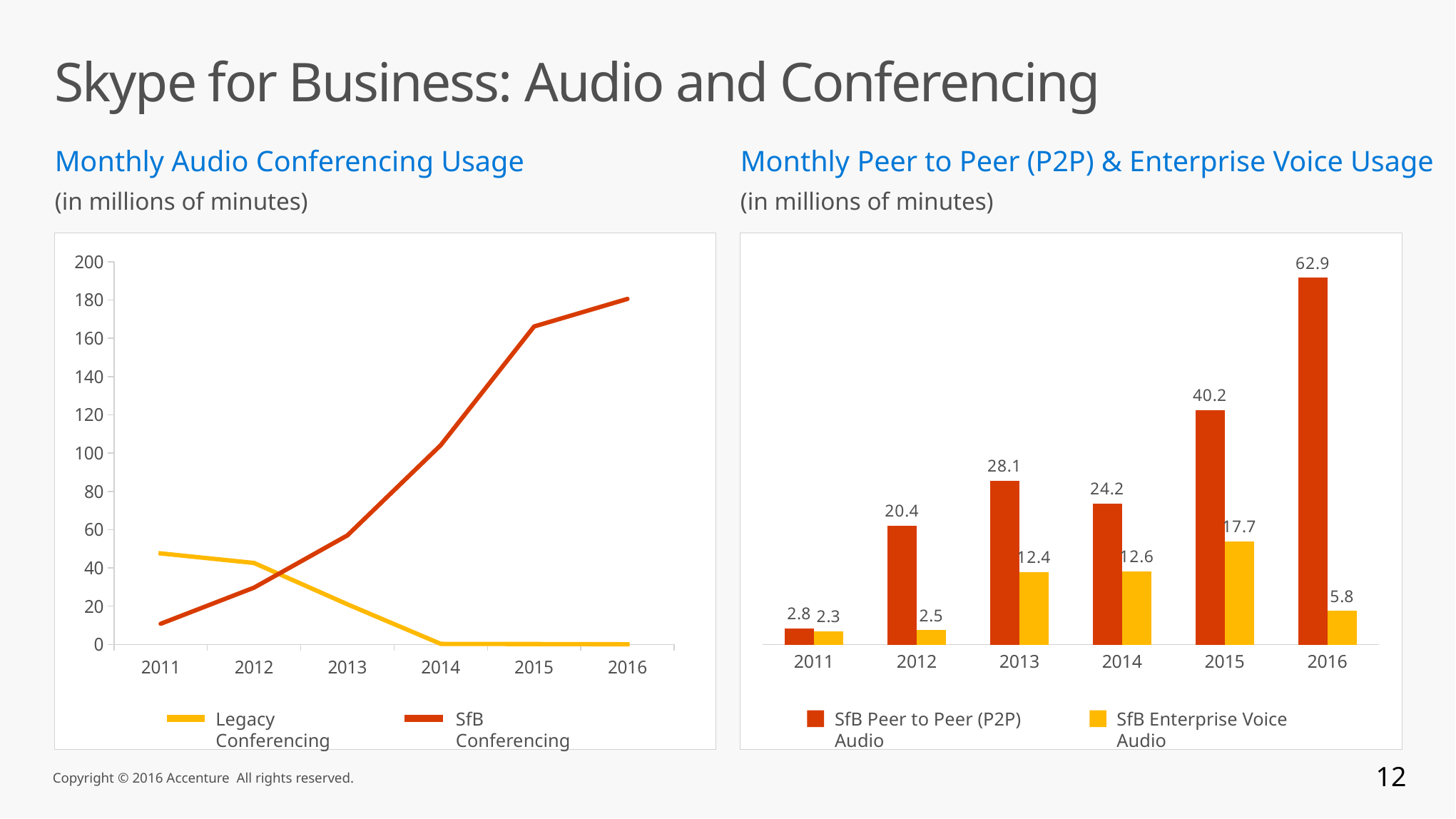
In the Monthly Peer to Peer (P2P) & Enterprise Voice Usage chart, what is the difference between SfB Peer to Peer (P2P) Audio and SfB Enterprise Voice Audio in 2016? 57.1 In the Monthly Audio Conferencing Usage chart, is the value for SfB Conferencing in 2016 greater or less than 160? greater In the Monthly Audio Conferencing Usage chart, is the value for Legacy Conferencing in 2011 greater or less than 60? less In the Monthly Peer to Peer (P2P) & Enterprise Voice Usage chart, how many years are shown on the x axis? 6 In the Monthly Peer to Peer (P2P) & Enterprise Voice Usage chart, what is the value for SfB Enterprise Voice Audio in 2013? 12.4 What type of chart is the Monthly Audio Conferencing Usage chart? line chart In the Monthly Peer to Peer (P2P) & Enterprise Voice Usage chart, which year has the highest SfB Peer to Peer (P2P) Audio value? 2016 What type of chart is the Monthly Peer to Peer (P2P) & Enterprise Voice Usage chart? bar chart In the Monthly Audio Conferencing Usage chart, does SfB Conferencing rise or fall from 2011 to 2016? rise In the Monthly Peer to Peer (P2P) & Enterprise Voice Usage chart, what is the value for SfB Peer to Peer (P2P) Audio in 2015? 40.2 In the Monthly Audio Conferencing Usage chart, how many series does the legend list? 2 In the Monthly Peer to Peer (P2P) & Enterprise Voice Usage chart, which year has the lowest SfB Enterprise Voice Audio value? 2011